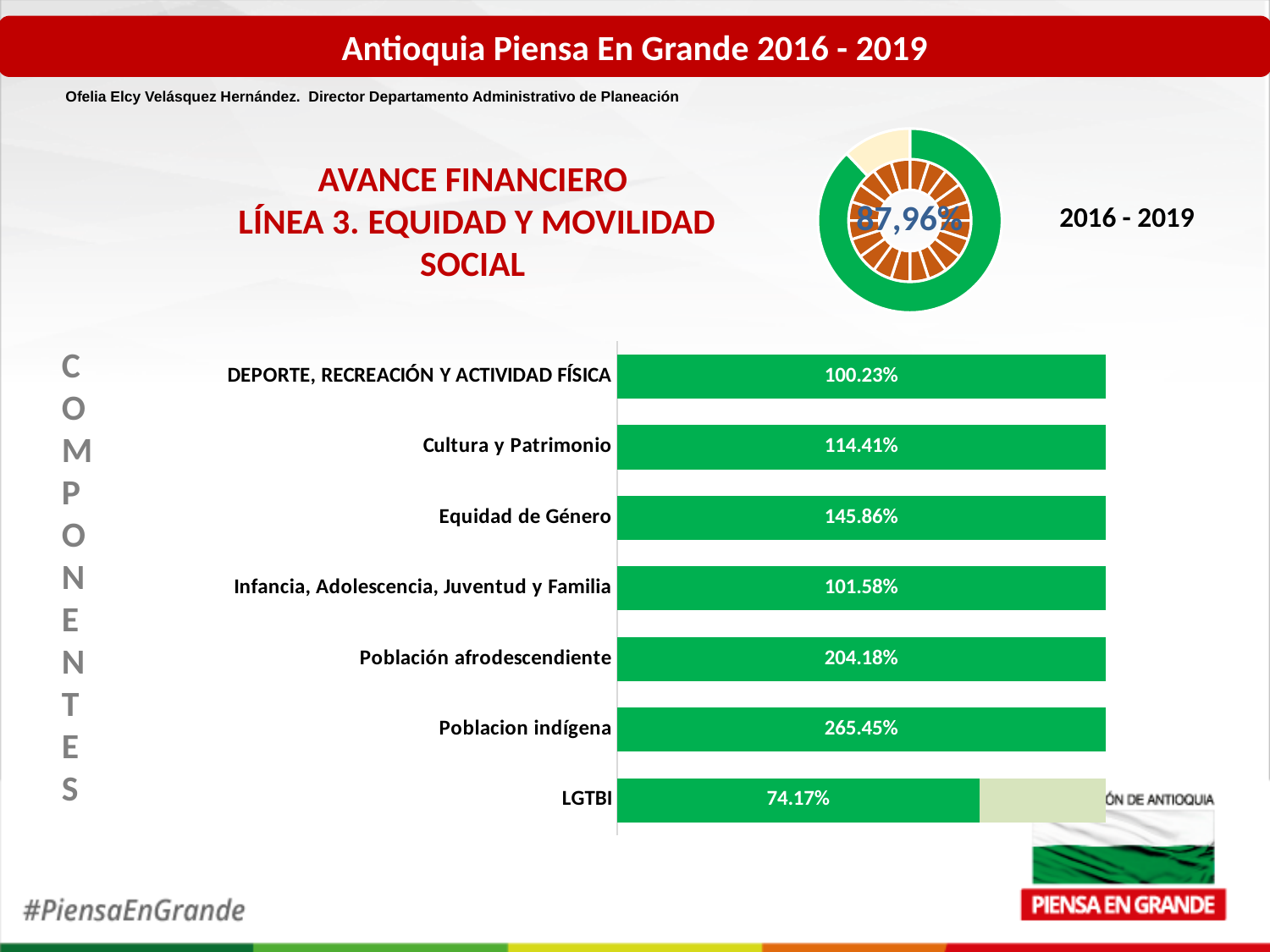
In the bar chart, what is the difference between the values for Cultura y Patrimonio and DEPORTE, RECREACIÓN Y ACTIVIDAD FÍSICA? 14.18% How many components are shown in the bar chart? 7 In the bar chart, what is the difference between the values for Poblacion indígena and Población afrodescendiente? 61.27% In the bar chart, which is larger: the value for Infancia, Adolescencia, Juventud y Familia or the value for Cultura y Patrimonio? Cultura y Patrimonio What kind of chart is used to show the components? Bar chart In the bar chart, which component has the lowest value? LGTBI In the bar chart, what is the value for Población afrodescendiente? 204.18% In the bar chart, which component has the highest value? Poblacion indígena In the bar chart, what is the value for Equidad de Género? 145.86% What period is shown next to the donut chart? 2016 - 2019 In the bar chart, what is the value for LGTBI? 74.17% What percentage is shown in the centre of the donut chart at the top of the slide? 87,96%